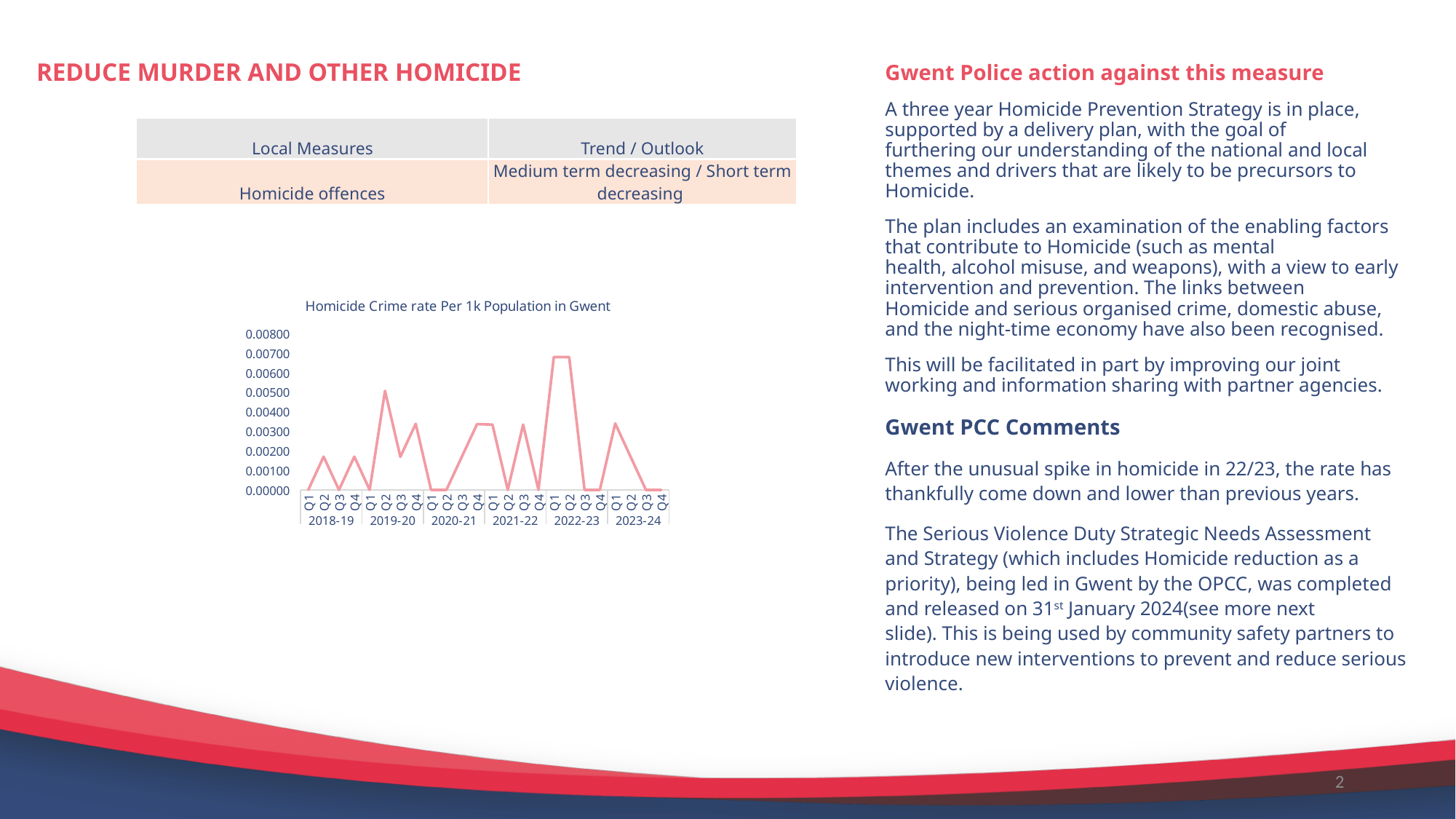
Is the value for Q1 2022-23 greater or less than 0.00600? greater Is the value for Q2 2019-20 greater or less than 0.00400? greater Do the values rise or fall from Q2 2022-23 to Q4 2022-23? fall In which financial year does the chart reach its highest peak? 2022-23 What is the value for Q1 2018-19 on the chart? 0.00000 What kind of chart is shown on the slide? line chart What is the title of the chart on the slide? Homicide Crime rate Per 1k Population in Gwent How many quarterly data points are plotted on the chart? 24 Which is larger, the value for Q2 2019-20 or the value for Q2 2018-19? Q2 2019-20 What is the value for Q4 2023-24 on the chart? 0.00000 How many financial years are shown along the x axis of the chart? 6 Is the value for Q2 2018-19 greater or less than 0.00300? less